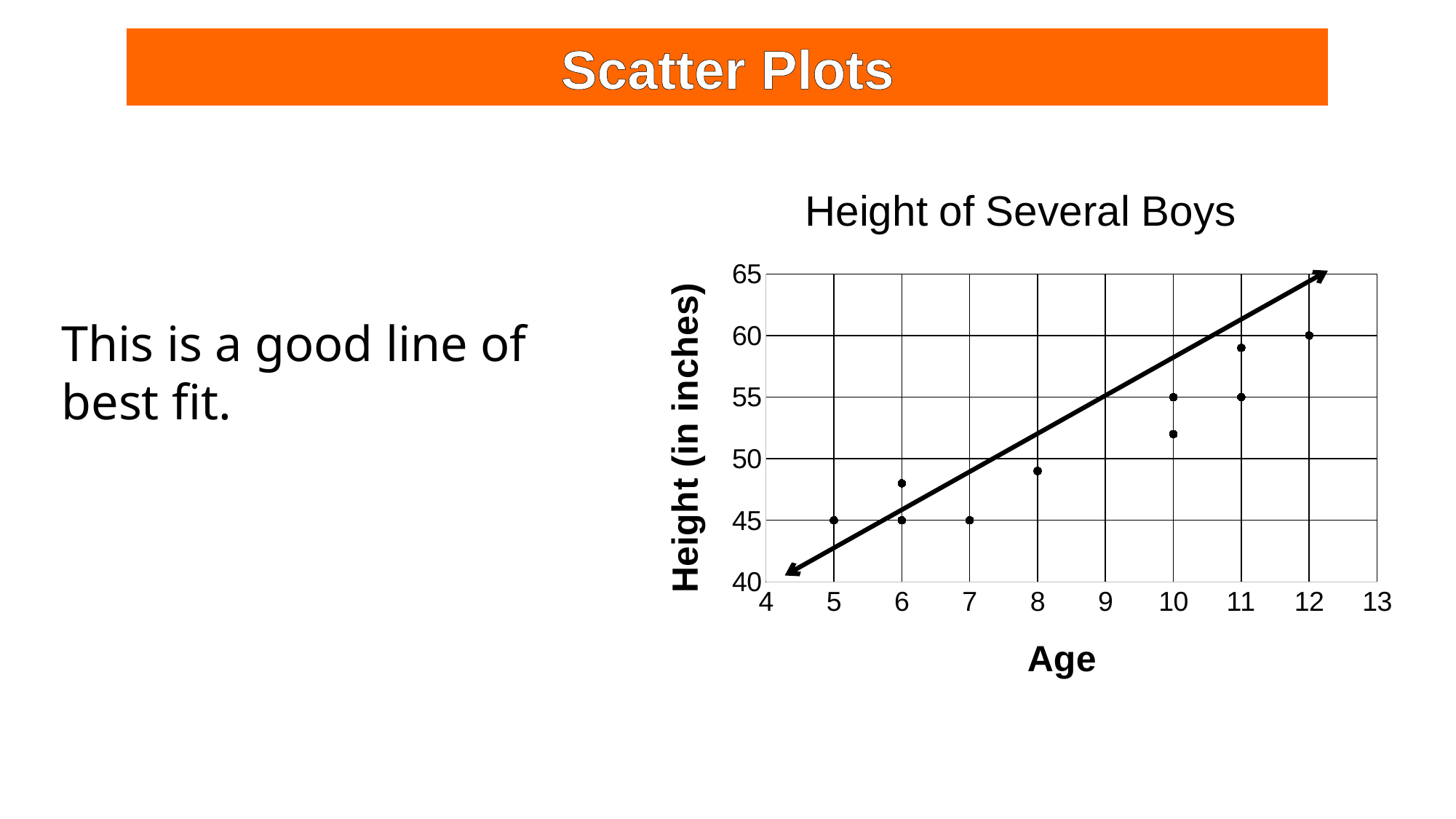
Do the plotted heights generally rise or fall as age increases? rise What is the height plotted for the boy aged 7? 45 What is the label of the vertical axis of the chart? Height (in inches) What is the height plotted for the boy aged 12? 60 At which age is the highest height plotted? 12 Which is larger, the height plotted at age 12 or the height plotted at age 5? age 12 Is the height plotted for the boy aged 8 greater or less than 50? less How many data points are plotted on the chart? 10 What is the height plotted for the boy aged 5? 45 What is the title of the chart? Height of Several Boys Is the height plotted for the boy aged 8 greater or less than 45? greater What kind of chart is shown on the slide? Scatter plot